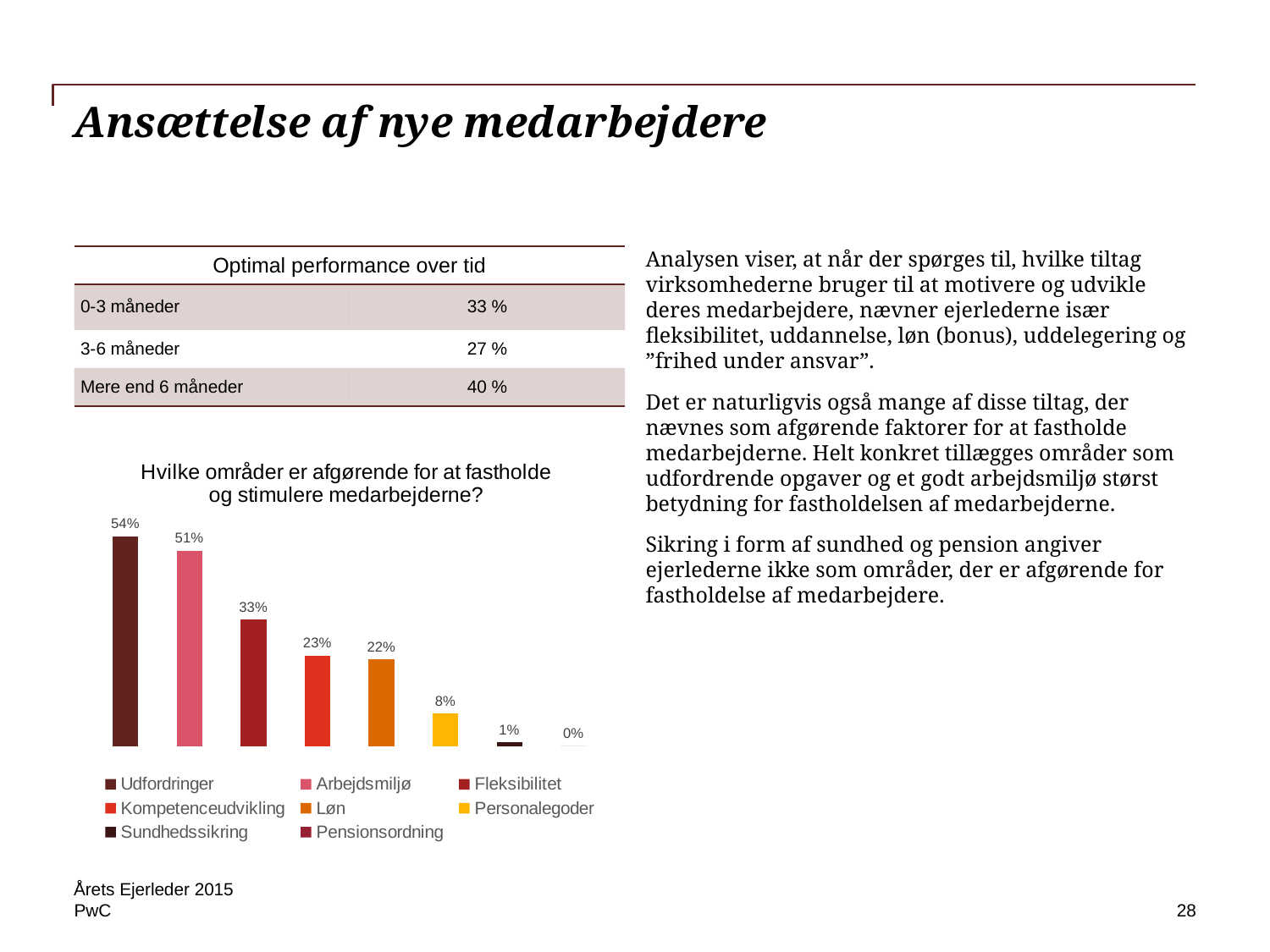
What is the difference between the values for Udfordringer and Fleksibilitet? 21% Which category has the lowest value in the chart? Pensionsordning What is the value for Fleksibilitet in the chart? 33% Which is larger, the value for Kompetenceudvikling or the value for Personalegoder? Kompetenceudvikling What is the value for Arbejdsmiljø in the chart? 51% What is the value for Udfordringer in the chart? 54% What is the value for Løn in the chart? 22% What is the value for Personalegoder in the chart? 8% How many entries does the chart's legend list? 8 What kind of chart is shown on the slide? Bar chart How many bars are shown in the chart? 8 Which category has the highest value in the chart? Udfordringer